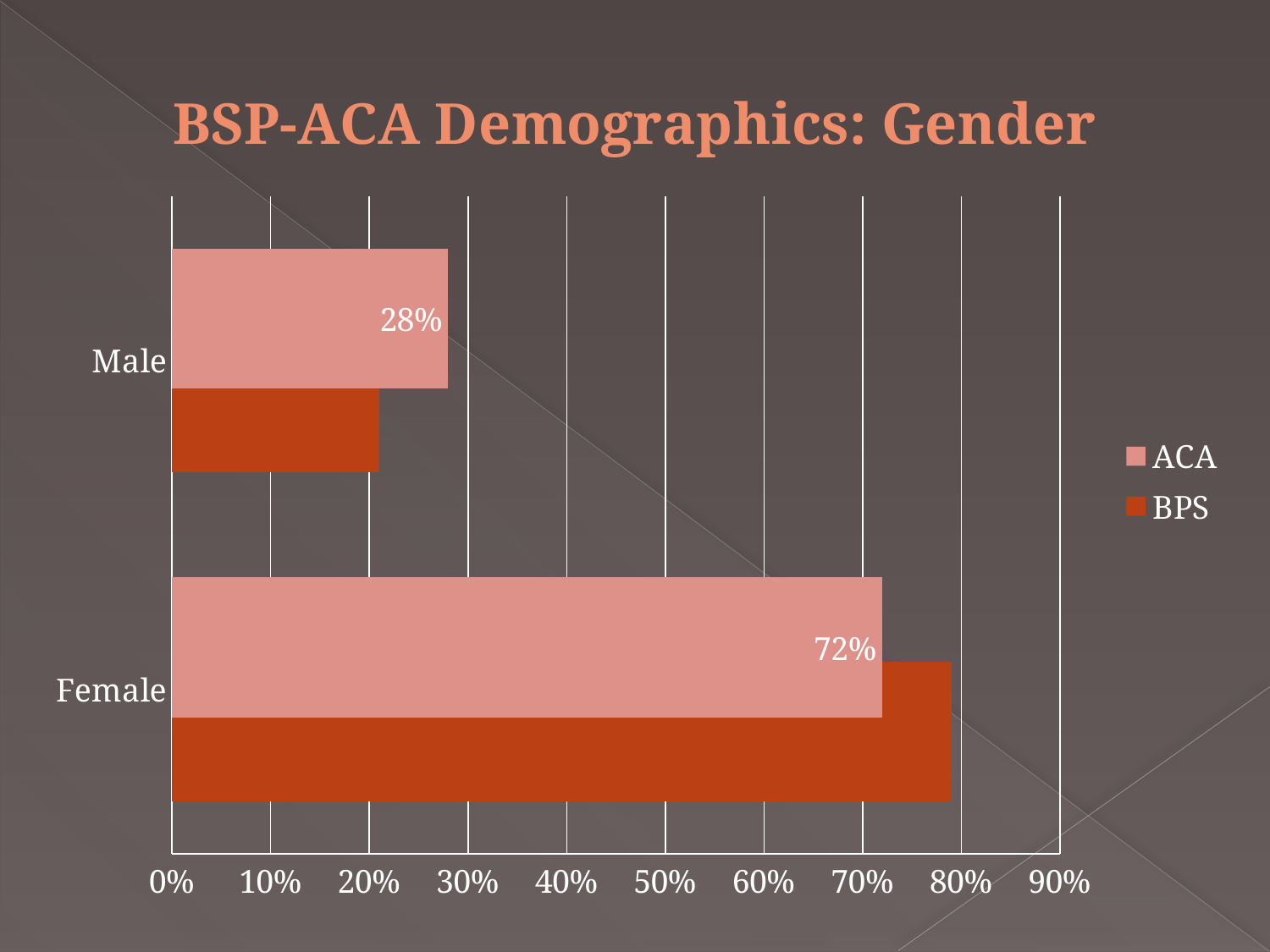
What is the ACA value for Female? 72% What kind of chart is shown on the slide? Bar chart What is the difference between the ACA values for Female and Male? 44% Is the BPS value for Male greater or less than 30%? less How many categories are shown on the chart? 2 For Male, which series has the larger value, ACA or BPS? ACA Which category has the highest ACA value? Female Is the BPS value for Female greater or less than 70%? greater Which category has the lowest BPS value? Male What is the ACA value for Male? 28% For Female, which series has the larger value, ACA or BPS? BPS How many series does the legend list? 2